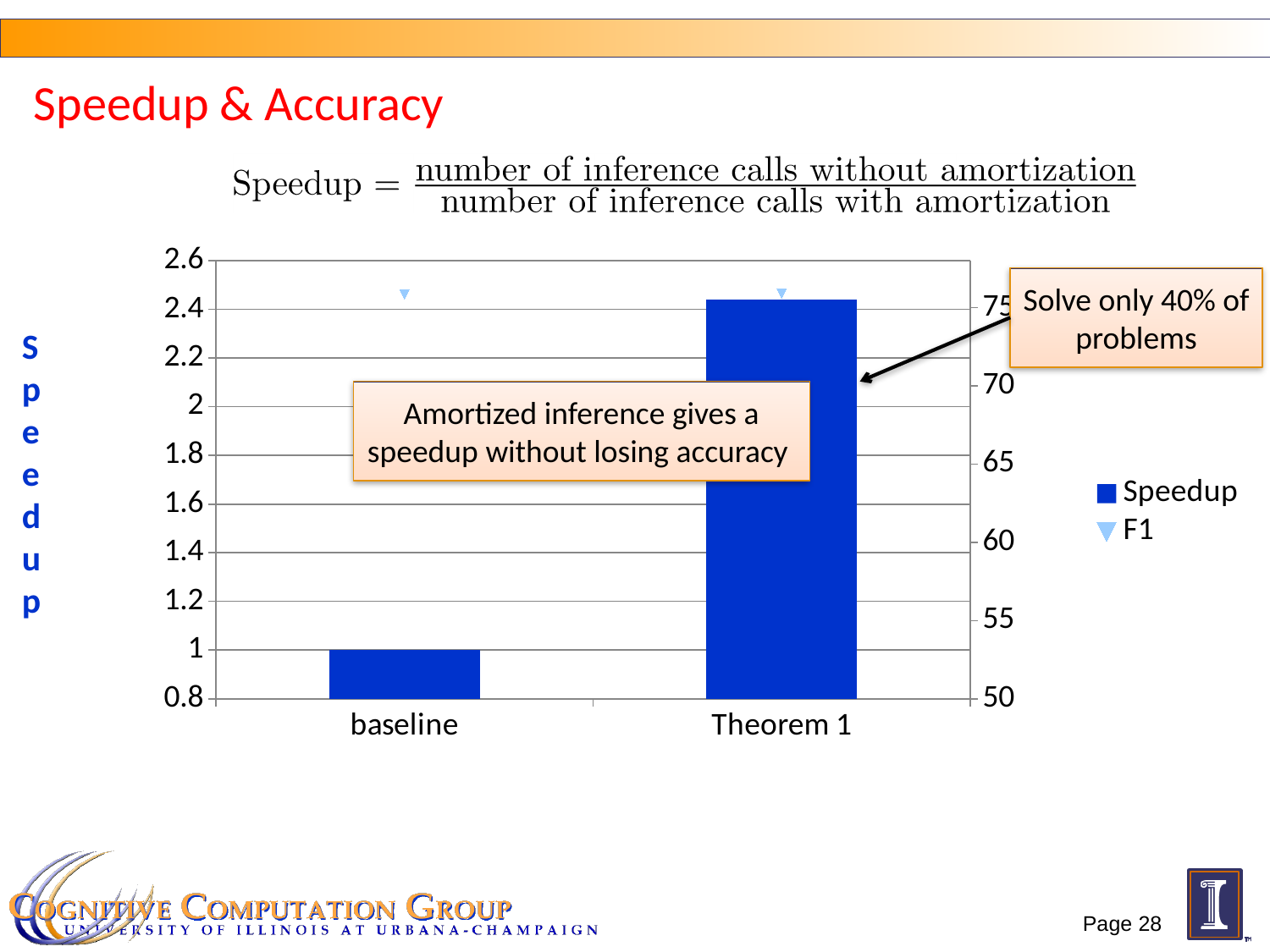
Does the Speedup rise or fall from baseline to Theorem 1? rise Which category has the lowest Speedup? baseline How many categories are shown on the x axis of the chart? 2 Which category has the higher Speedup, baseline or Theorem 1? Theorem 1 Is the Speedup value for Theorem 1 greater or less than 2.2? greater Is the F1 value for baseline greater or less than 70 on the right-hand axis? greater What kind of chart is shown on the slide? bar chart Is the Speedup value for Theorem 1 greater or less than 2? greater What is the Speedup value for baseline? 1 What are the two series named in the chart's legend? Speedup and F1 How many series does the chart's legend list? 2 Which category has the highest Speedup? Theorem 1